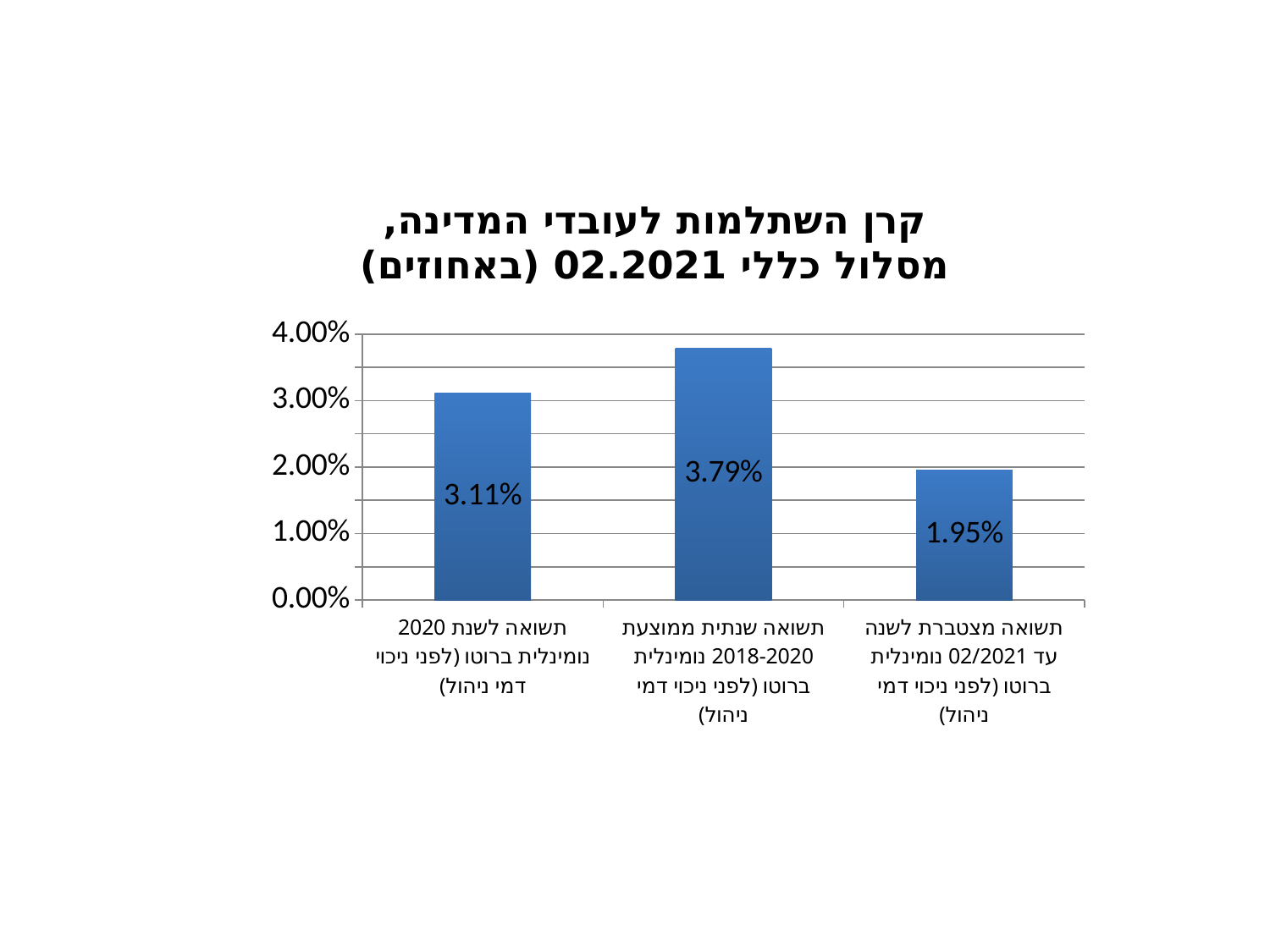
How many bars are shown in the chart? 3 Which is larger: the return for 2020 or the cumulative return for the year to 02/2021? the return for 2020 (3.11%) Which category has the lowest value? תשואה מצטברת לשנה עד 02/2021 נומינלית ברוטו (לפני ניכוי דמי ניהול) What is the difference between the average annual return 2018-2020 (3.79%) and the return for 2020 (3.11%)? 0.68% Which category has the highest value? תשואה שנתית ממוצעת 2018-2020 נומינלית ברוטו (לפני ניכוי דמי ניהול) Is the value for the cumulative return to 02/2021 greater or less than 2.00%? less What is the value for "תשואה מצטברת לשנה עד 02/2021 נומינלית ברוטו" (cumulative nominal gross return for the year to 02/2021)? 1.95% What is the title of the chart? קרן השתלמות לעובדי המדינה, מסלול כללי 02.2021 (באחוזים) What kind of chart is shown on the slide? bar chart What is the value for "תשואה לשנת 2020 נומינלית ברוטו (לפני ניכוי דמי ניהול)" (nominal gross return for 2020)? 3.11% What is the difference between the return for 2020 (3.11%) and the cumulative return to 02/2021 (1.95%)? 1.16% What is the value for "תשואה שנתית ממוצעת 2018-2020 נומינלית ברוטו" (average annual nominal gross return 2018-2020)? 3.79%